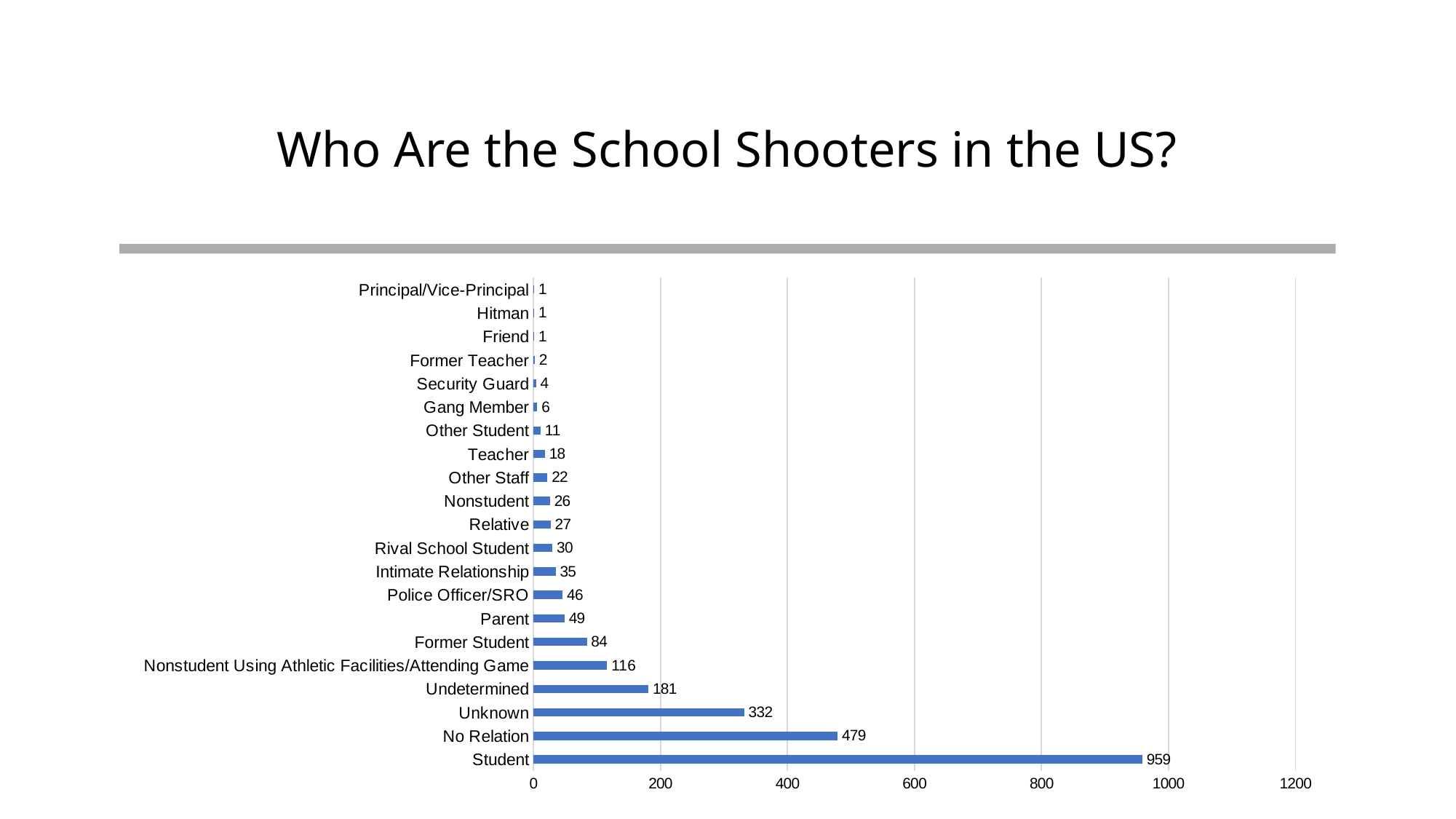
What is the difference between the values for Unknown and Undetermined? 151 Which category has the highest value? Student What is the value for Nonstudent Using Athletic Facilities/Attending Game? 116 What is the difference between the values for Student and No Relation? 480 What is the value for No Relation? 479 What kind of chart is shown on the slide? bar chart What is the value for Student? 959 How many categories are shown in the chart? 21 Is the value for Unknown greater or less than 400? less Which is larger, the value for Parent or the value for Police Officer/SRO? Parent What is the value for Former Student? 84 What is the title of the slide? Who Are the School Shooters in the US?